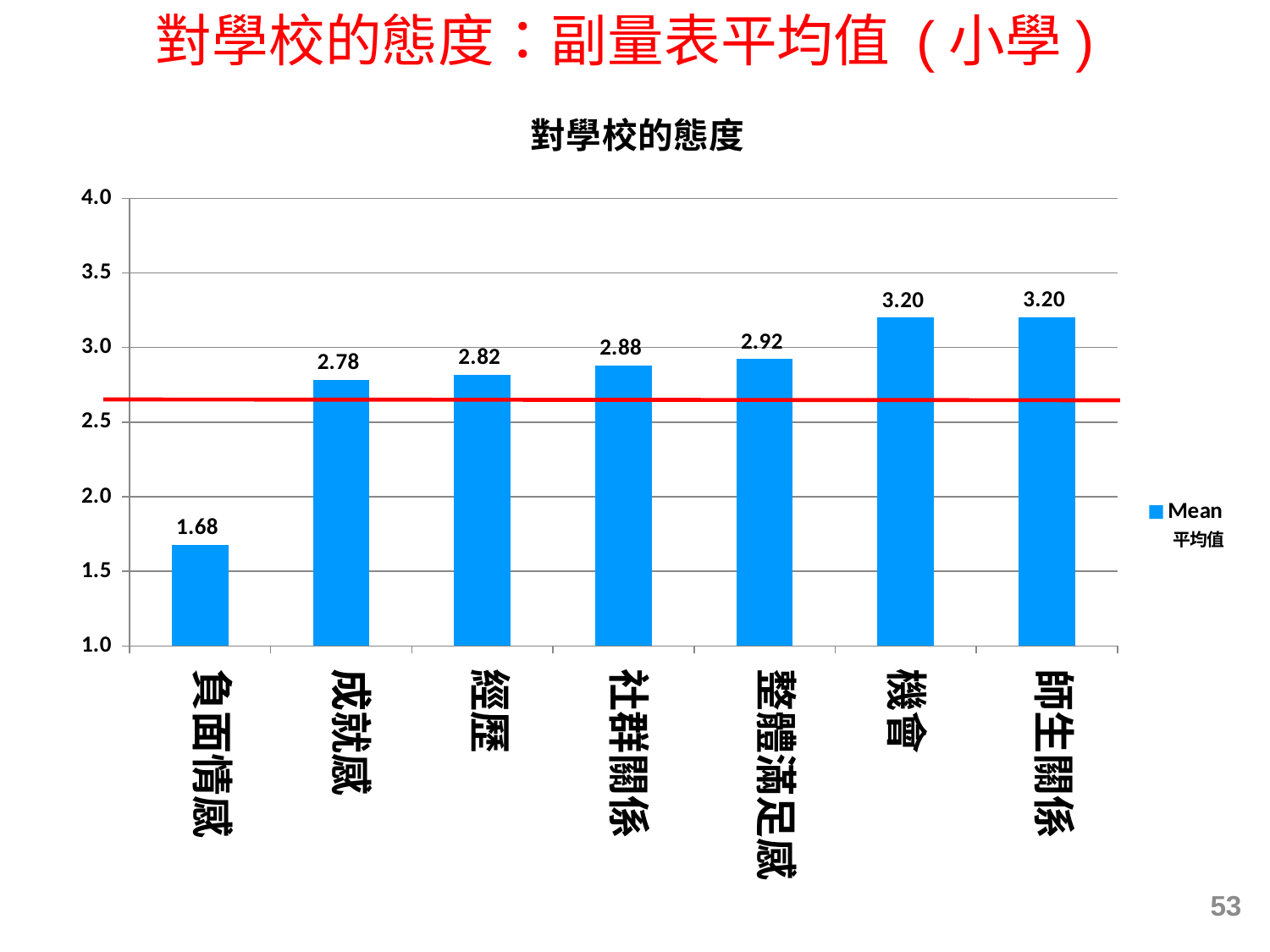
Which category has the lowest value? 負面情感 What is the value for 社群關係? 2.88 What is the value for 負面情感? 1.68 What is the difference between the values for 機會 and 負面情感? 1.52 Which is larger, the value for 整體滿足感 or the value for 成就感? 整體滿足感 Is the value for 負面情感 greater or less than 2.0? less What is the value for 整體滿足感? 2.92 What is the highest value shown in the chart? 3.20 What kind of chart is shown on the slide? bar chart How many categories are shown in the chart? 7 What is the title of the chart? 對學校的態度 What is the difference between the values for 經歷 and 成就感? 0.04